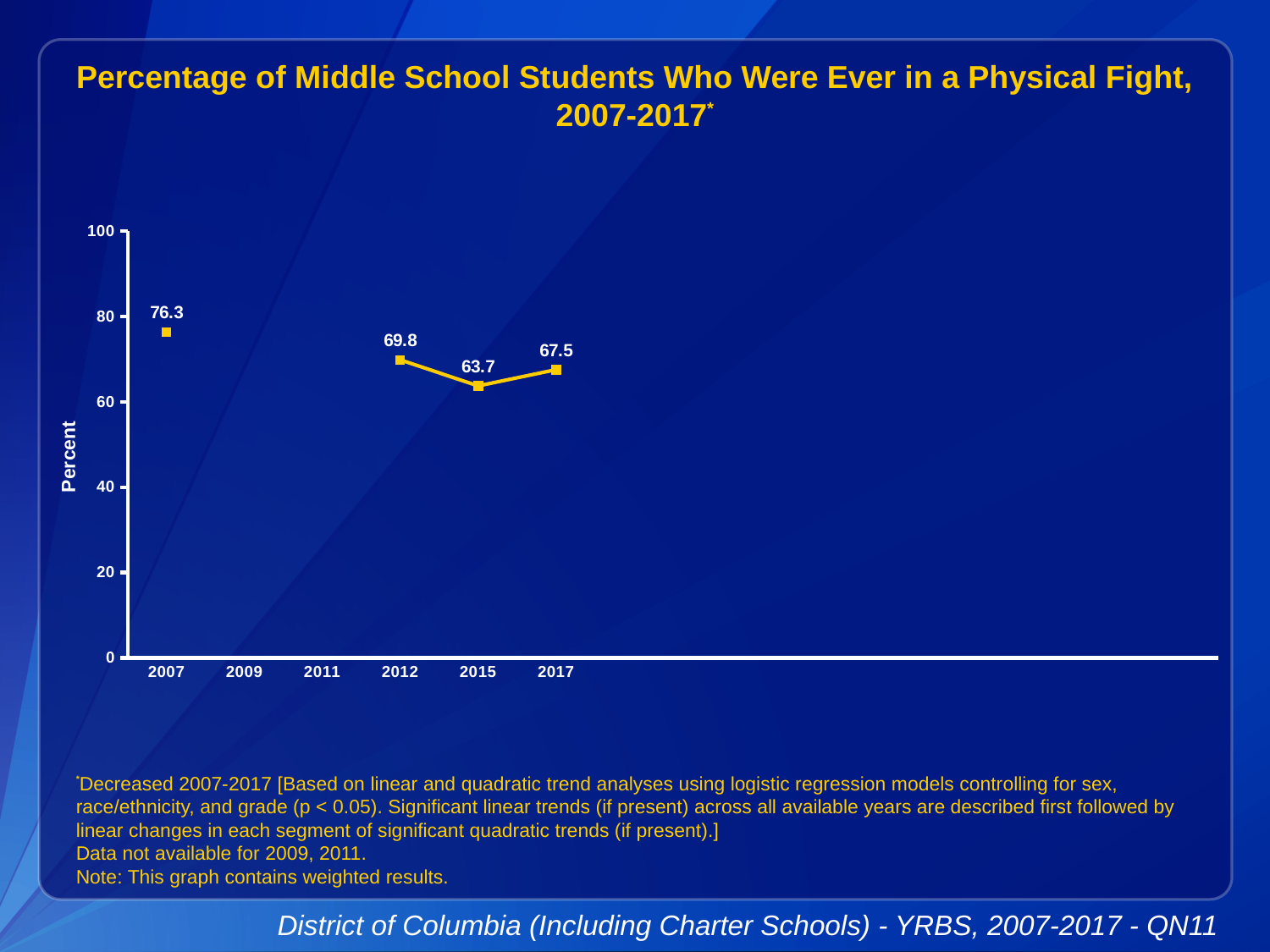
How many years have data points plotted on the chart? 4 By how many percentage points did the value change from 2007 to 2017? 8.8 What is the difference between the 2012 and 2015 values? 6.1 Is the value for 2007 greater or less than 80? less What type of chart is shown on the slide? line chart Which year had the lowest percentage of middle school students who were ever in a physical fight? 2015 What was the percentage of middle school students who were ever in a physical fight in 2007? 76.3 What was the percentage of middle school students who were ever in a physical fight in 2017? 67.5 What was the percentage of middle school students who were ever in a physical fight in 2015? 63.7 Which year had the highest percentage of middle school students who were ever in a physical fight? 2007 What was the percentage of middle school students who were ever in a physical fight in 2012? 69.8 Which year had a higher value, 2015 or 2017? 2017